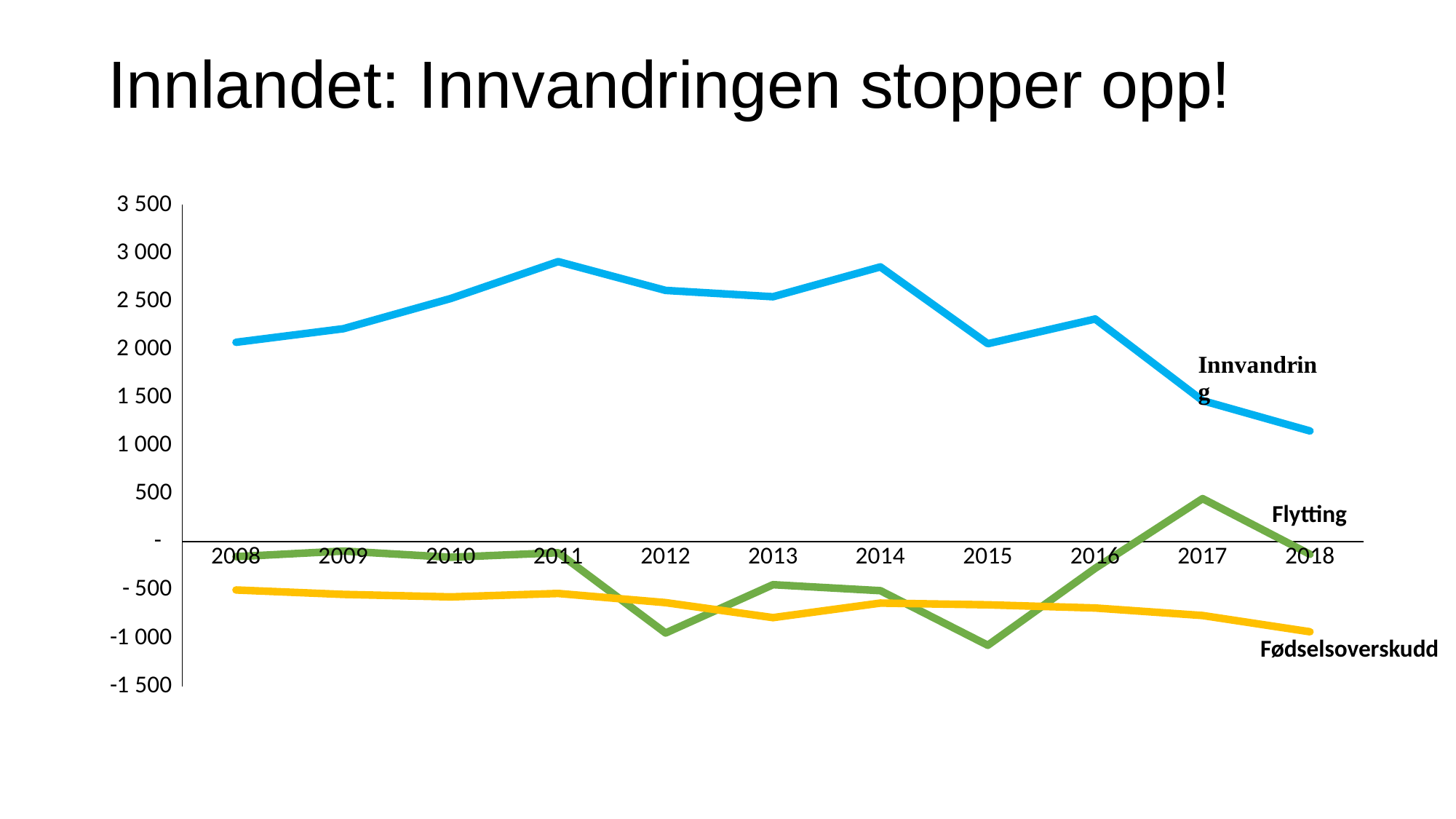
What is the title of the slide? Innlandet: Innvandringen stopper opp! Is the value for Innvandring in 2011 greater or less than 2 500? greater In which year is the Flytting series at its highest? 2017 In 2018, which is larger: Innvandring or Flytting? Innvandring Is the value for Flytting in 2012 greater or less than -500? less Is the value for Innvandring in 2018 greater or less than 1 500? less What kind of chart is shown on the slide? line chart How many series are plotted in the chart? 3 In which year is the Innvandring series at its lowest? 2018 Does the Innvandring series rise or fall from 2014 to 2018? fall How many years are plotted along the x axis? 11